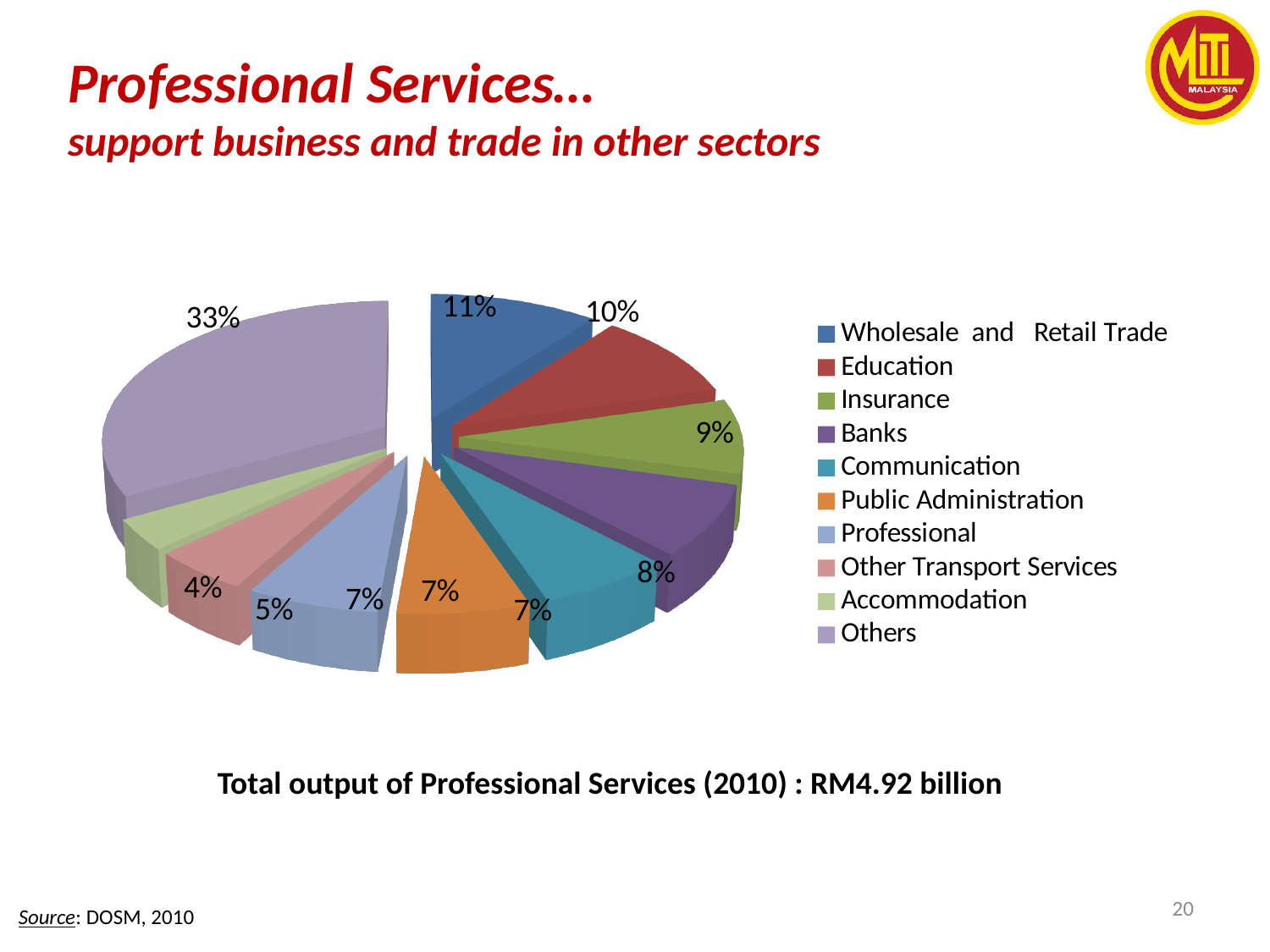
What is the value shown for Education? 10% Which category has the smallest share of the pie? Accommodation What is the value shown for Wholesale and Retail Trade? 11% How many categories does the pie chart show? 10 What share of the pie does Others account for? 33% What is the value shown for Insurance? 9% What is the value shown for Accommodation? 4% Which is larger, the share for Education or the share for Other Transport Services? Education Which category has the largest share of the pie? Others What is the difference in percentage points between Others and Wholesale and Retail Trade? 22% What is the value shown for Banks? 8% What kind of chart is shown on the slide? Pie chart